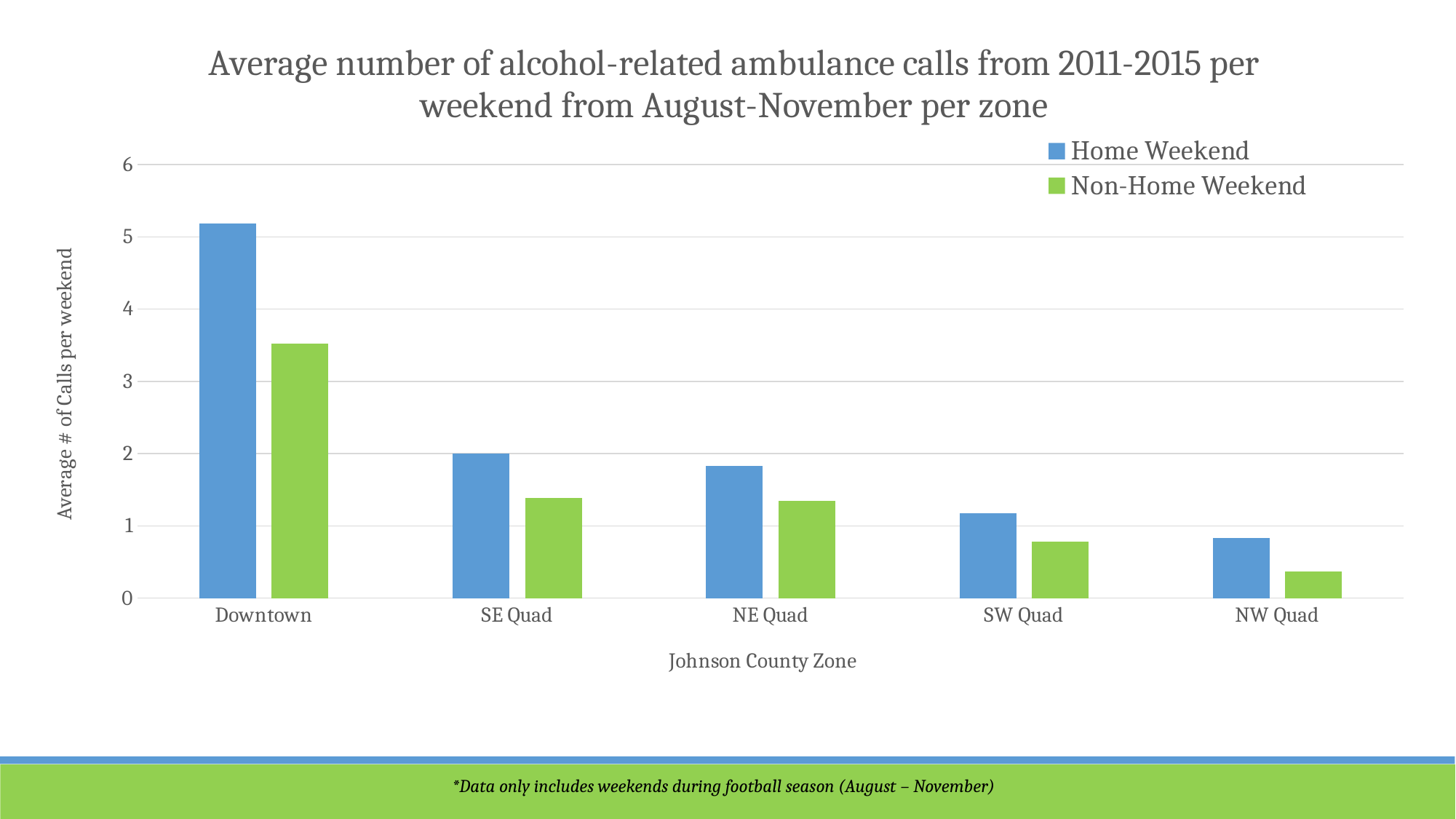
Is the Non-Home Weekend value for NW Quad greater or less than 1? less How many zones are shown on the x axis? 5 What is the label of the y axis? Average # of Calls per weekend For Downtown, which is larger: Home Weekend or Non-Home Weekend? Home Weekend Which zone has the lowest Non-Home Weekend value? NW Quad Which zone has the highest Home Weekend value? Downtown Do the Home Weekend values rise or fall from Downtown to NW Quad along the x axis? fall Which zone has the lowest Home Weekend value? NW Quad What kind of chart is shown on the slide? bar chart Is the Non-Home Weekend value for Downtown greater or less than 4? less How many series does the legend list? 2 Is the Home Weekend value for Downtown greater or less than 5? greater